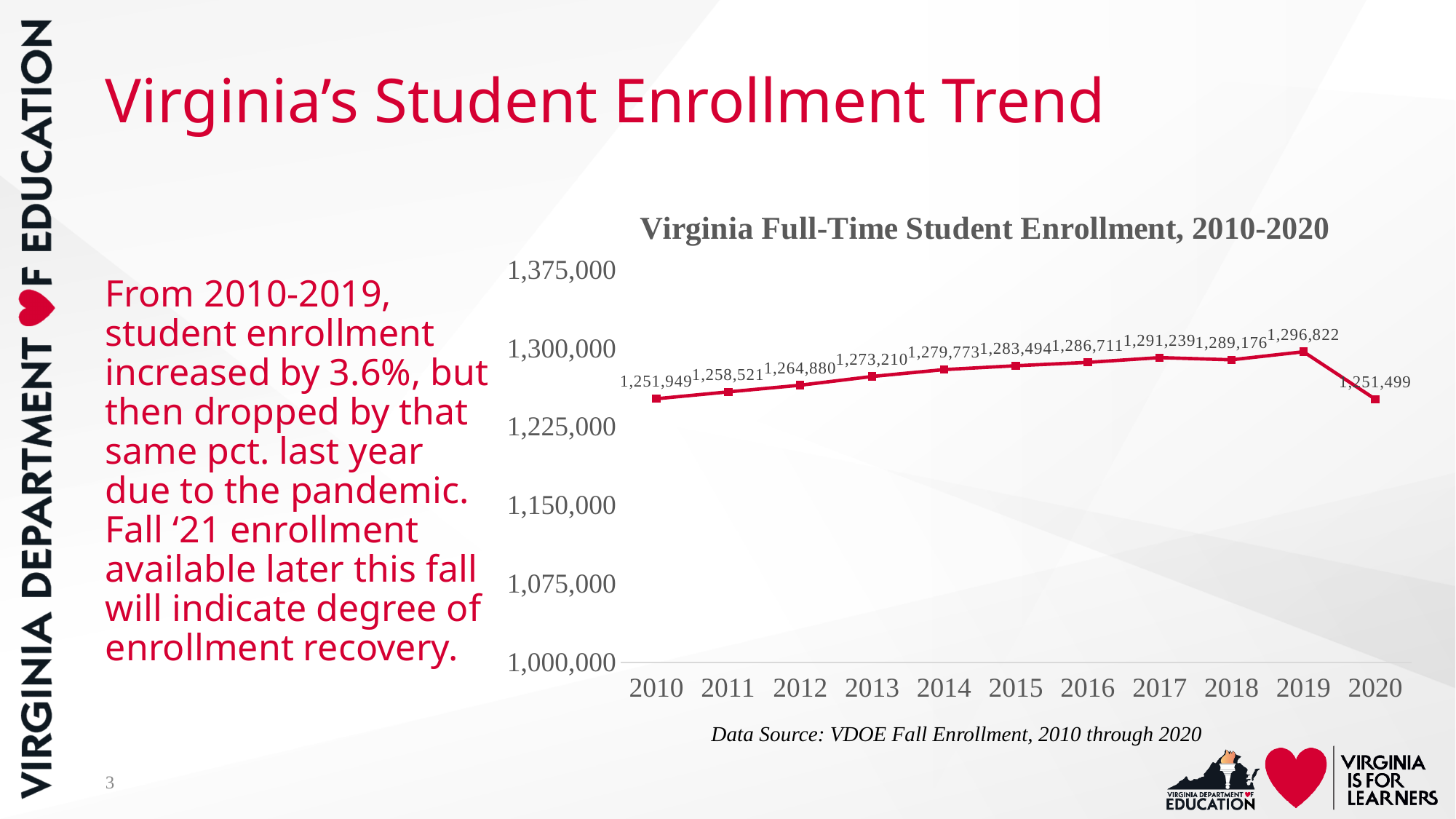
What was Virginia's full-time student enrollment in 2020? 1,251,499 How many years are plotted on the chart? 11 Is the enrollment value for 2020 greater or less than 1,300,000? less What was Virginia's full-time student enrollment in 2019? 1,296,822 Which year had the highest full-time student enrollment? 2019 Which year had higher enrollment, 2017 or 2018? 2017 Did enrollment generally rise or fall from 2010 to 2017? Rise What was Virginia's full-time student enrollment in 2015? 1,283,494 What type of chart is shown on the slide? Line chart By how much did enrollment drop from 2019 to 2020? 45,323 What is the chart's title? Virginia Full-Time Student Enrollment, 2010-2020 What was Virginia's full-time student enrollment in 2010? 1,251,949